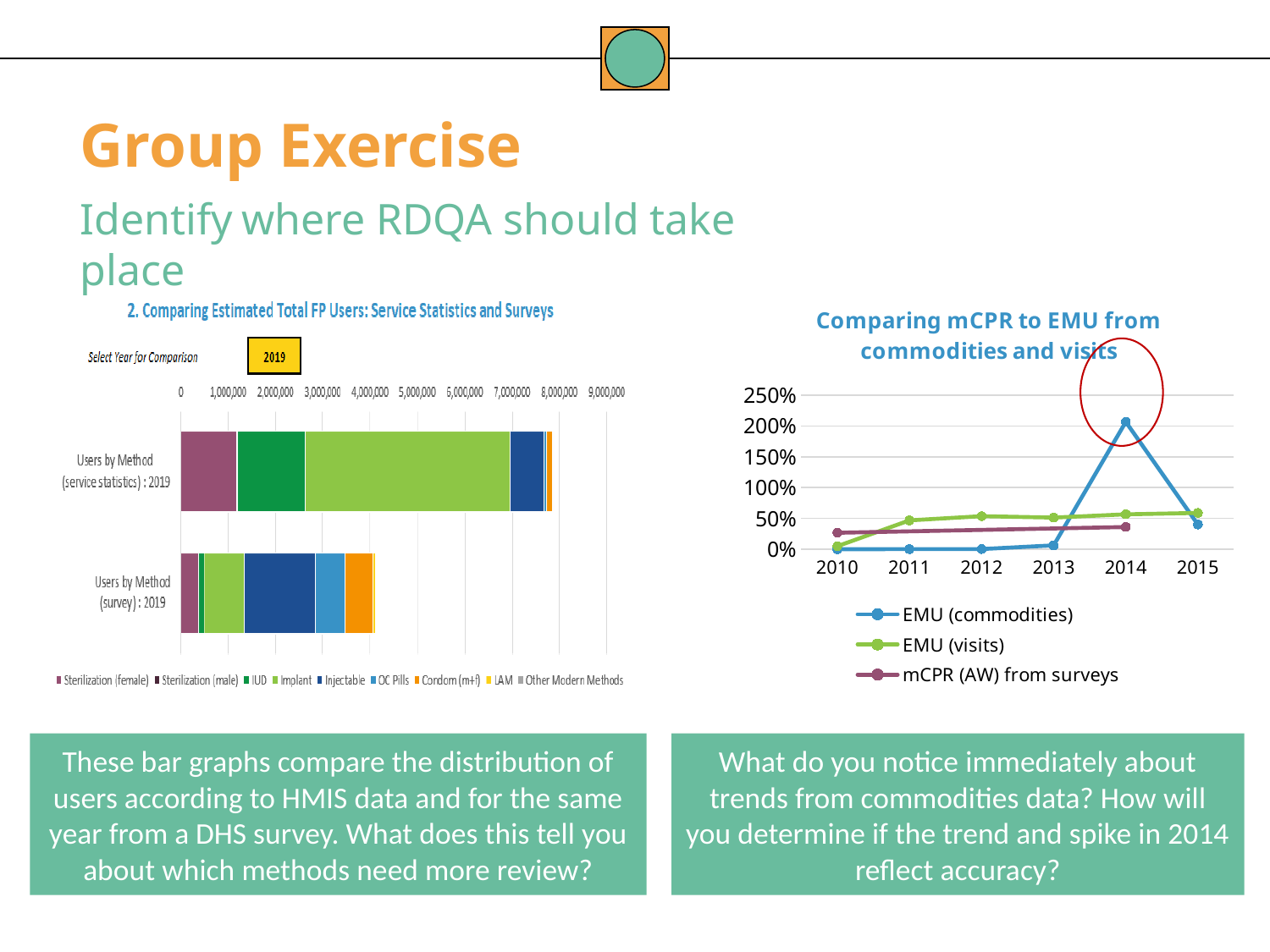
What kind of chart is the left chart titled '2. Comparing Estimated Total FP Users: Service Statistics and Surveys'? Bar chart In the right chart, how many years are shown on the x axis? 6 In the right chart, how many series does the legend list? 3 In the left chart, is the total length of the 'Users by Method (survey) : 2019' bar greater or less than 5,000,000? less In the left chart, how many bars (categories) are plotted? 2 In the left chart, how many series does the legend list? 9 In the left chart, is the total length of the 'Users by Method (service statistics) : 2019' bar greater or less than 7,000,000? greater What kind of chart is the right chart titled 'Comparing mCPR to EMU from commodities and visits'? Line chart In the left chart, which bar is longer in total: 'Users by Method (service statistics) : 2019' or 'Users by Method (survey) : 2019'? Users by Method (service statistics) : 2019 In the right chart, is the value of EMU (commodities) in 2014 greater or less than 150%? greater In the right chart, which is larger in 2014: EMU (commodities) or mCPR (AW) from surveys? EMU (commodities) In the right chart, in which year does EMU (commodities) reach its highest value? 2014